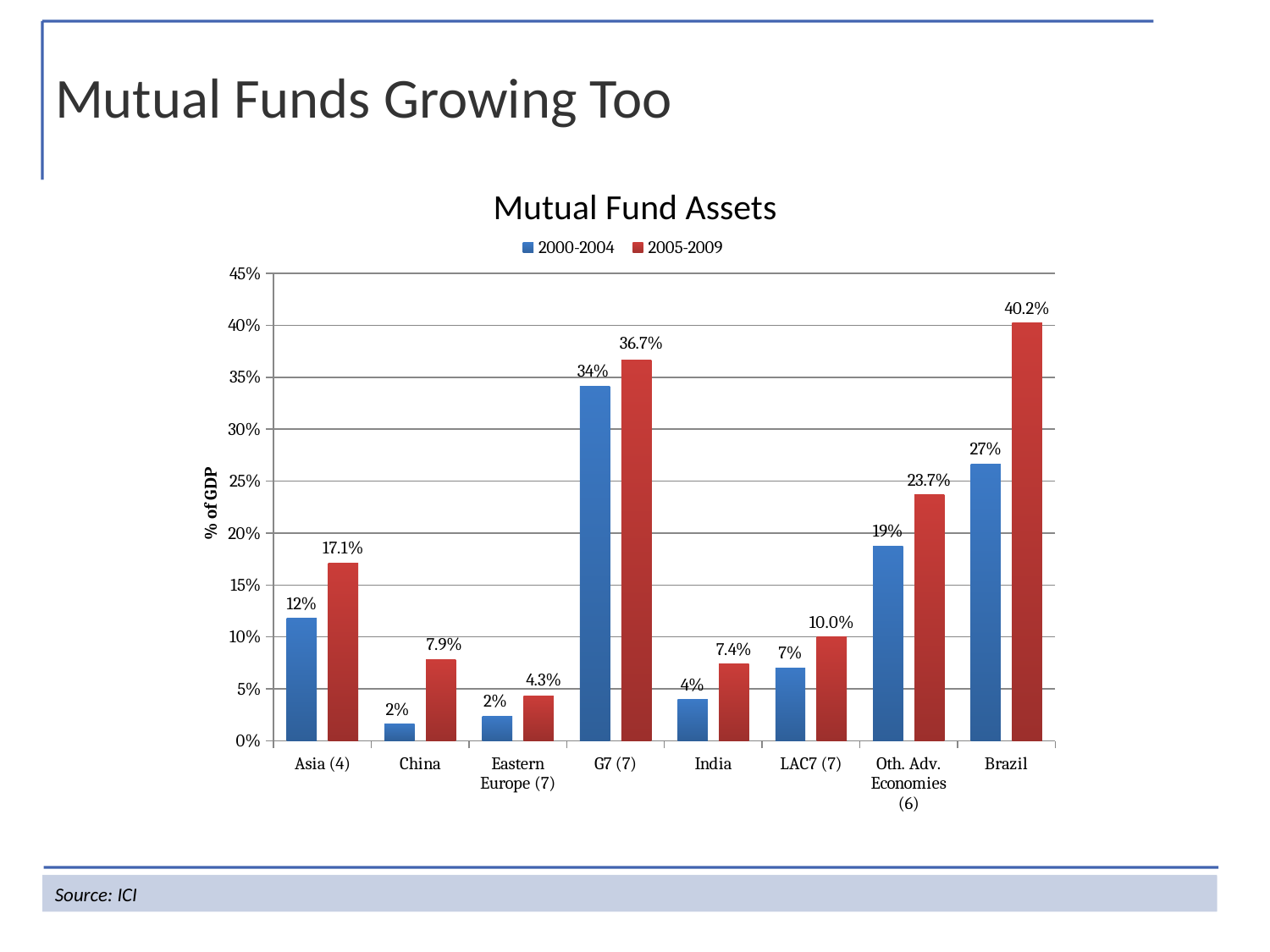
What kind of chart is shown? bar chart Is the 2000-2004 value for Brazil greater or less than 25%? greater What is the difference between the 2005-2009 and 2000-2004 values for Oth. Adv. Economies (6)? 4.7% Which is larger: the 2005-2009 value for China or the 2005-2009 value for India? China What is the title of the chart? Mutual Fund Assets What is the 2005-2009 value for Brazil? 40.2% What is the 2005-2009 value for Asia (4)? 17.1% Which category has the highest 2005-2009 value? Brazil How many categories are shown on the x axis? 8 How many series does the legend list? 2 Which category has the lowest 2005-2009 value? Eastern Europe (7) What is the 2000-2004 value for G7 (7)? 34%